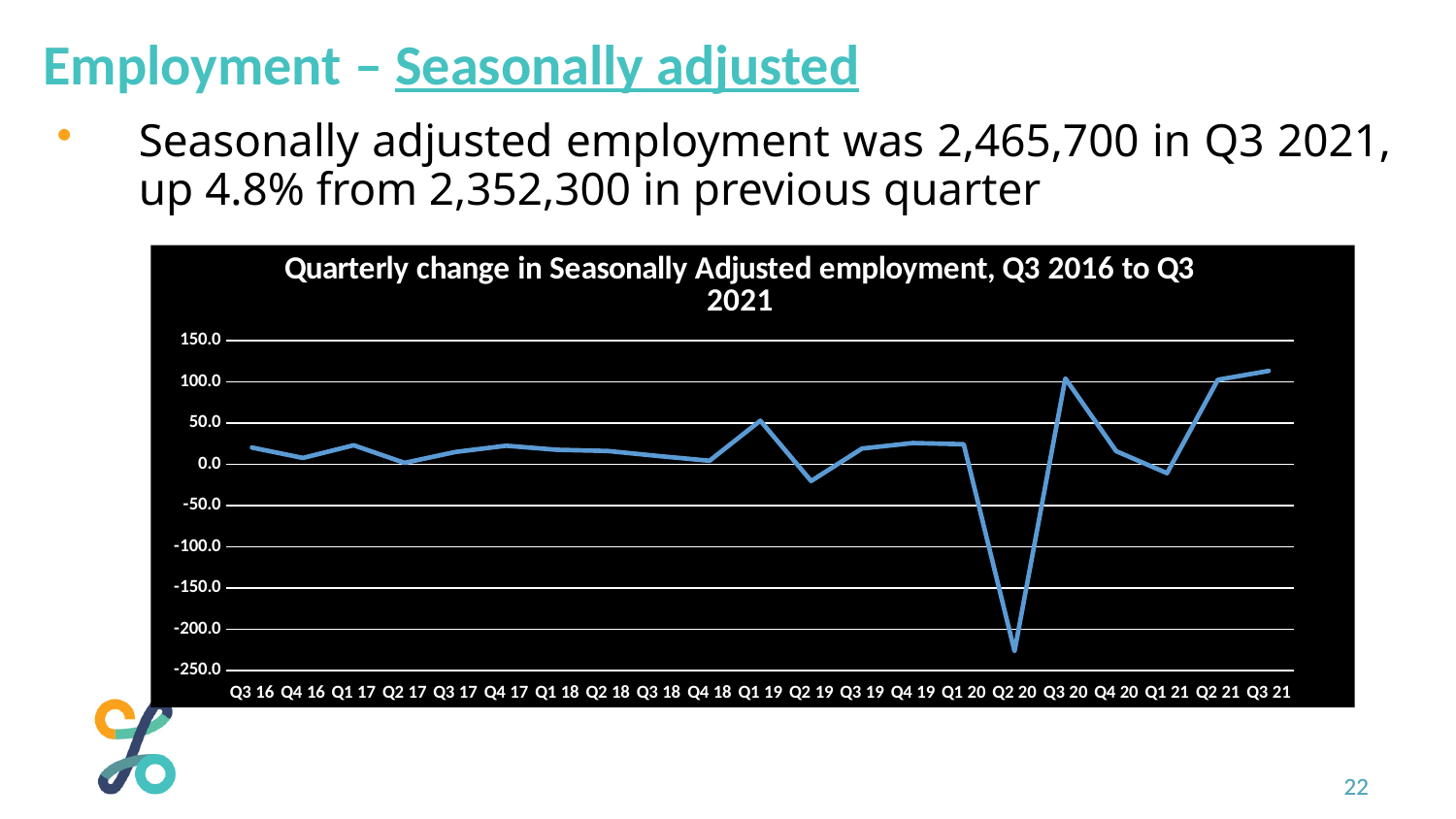
What kind of chart is shown on the slide? Line chart Is the value for Q3 20 greater or less than 50.0? greater Is the value for Q2 20 greater or less than -200.0? less Which quarter has the lowest value in the chart? Q2 20 How many quarters are plotted on the x axis of the chart? 21 Which quarter has the highest value in the chart? Q3 21 Is the value for Q2 19 greater or less than 0.0? less Does the line rise or fall from Q1 20 to Q2 20? Fall What is the lowest value shown on the y axis of the chart? -250.0 What is the title of the chart? Quarterly change in Seasonally Adjusted employment, Q3 2016 to Q3 2021 Which is larger, the value for Q2 20 or the value for Q3 20? Q3 20